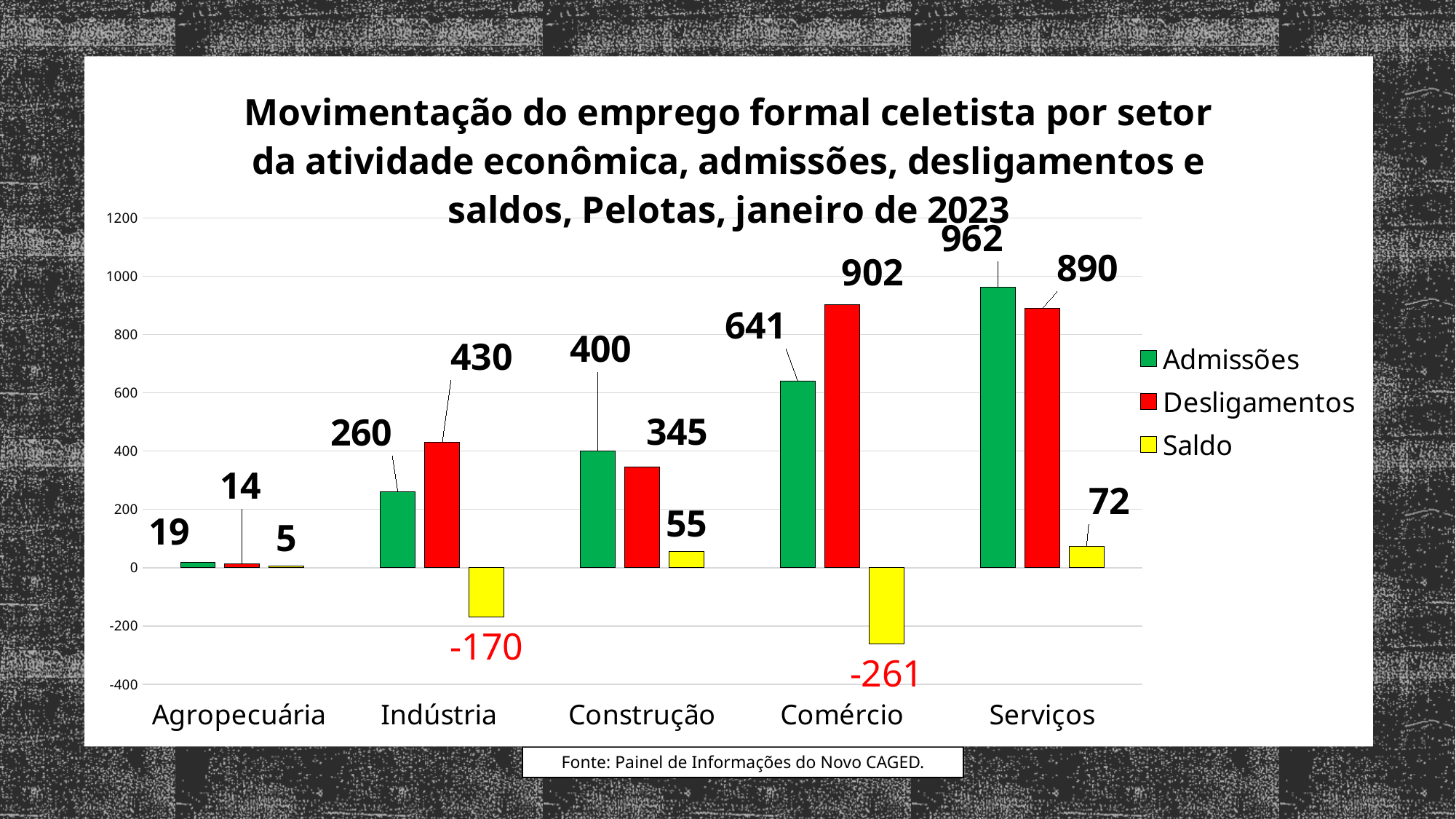
What is the value of Desligamentos for Indústria? 430 What is the value of Admissões for Comércio? 641 How many sectors are shown on the x axis? 5 What is the difference between Desligamentos and Admissões for Comércio? 261 What colour represents the Saldo series in the legend? yellow What is the Saldo for Serviços? 72 What kind of chart is shown on the slide? bar chart Which sector has the highest value of Admissões? Serviços Is the value of Desligamentos for Serviços greater or less than 800? greater Which sector has the lowest Saldo? Comércio How many series does the legend list? 3 Which is larger for Construção, Admissões or Desligamentos? Admissões